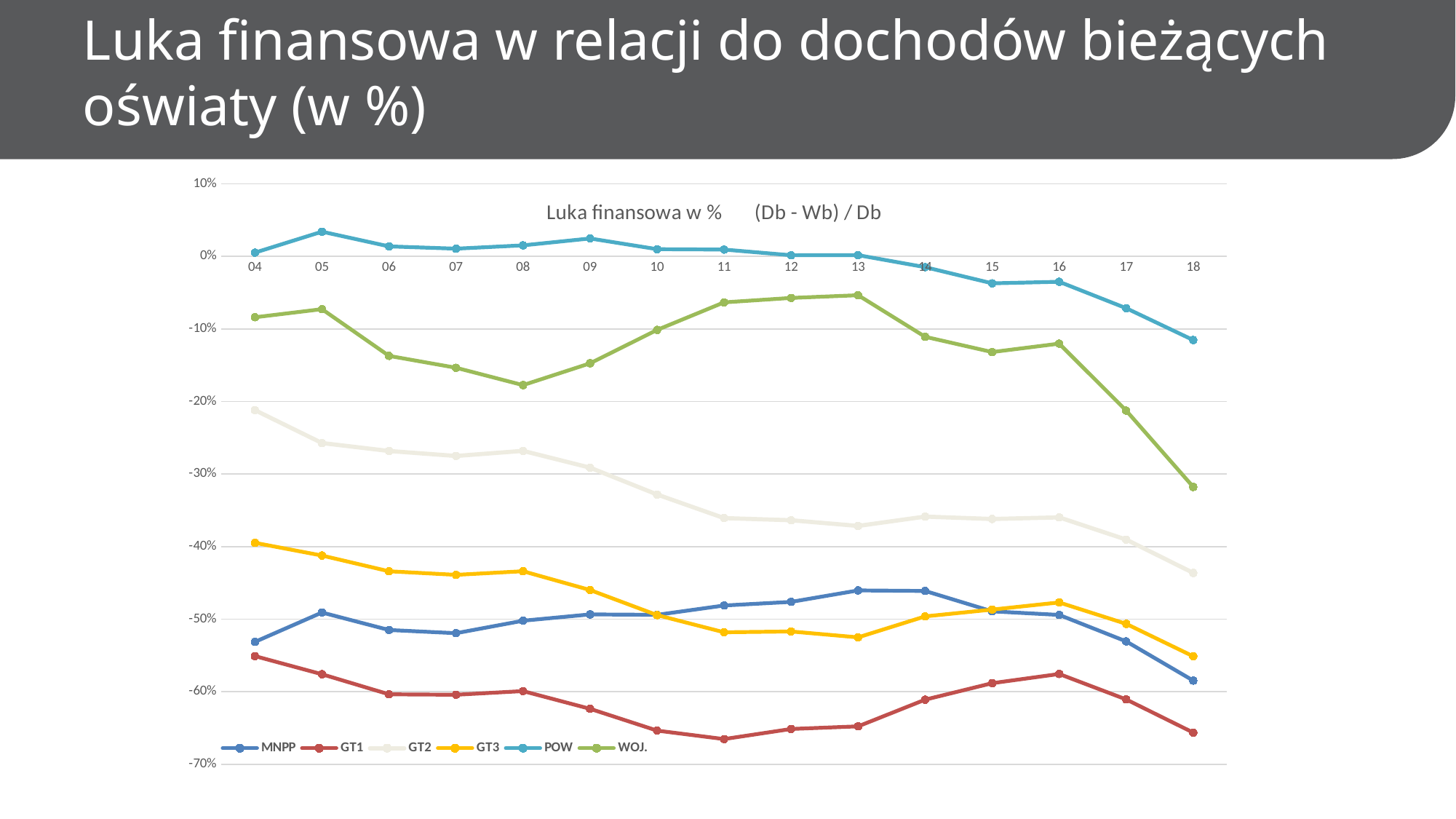
Which is larger for WOJ.: the value at 08 or the value at 13? 13 In which year does GT2 reach its lowest value? 18 Which series has the lowest value at 11? GT1 Which series has the highest value at 18? POW Is the value for MNPP at 13 greater or less than -50%? greater How many points are plotted along the x axis for each series? 15 What subtitle is printed inside the chart area? Luka finansowa w % (Db - Wb) / Db Do the values for GT2 rise or fall from 04 to 18? fall Is the value for WOJ. at 18 greater or less than -30%? less What kind of chart is shown on the slide? line chart Is the value for POW at 05 greater or less than 0%? greater How many series does the legend list? 6